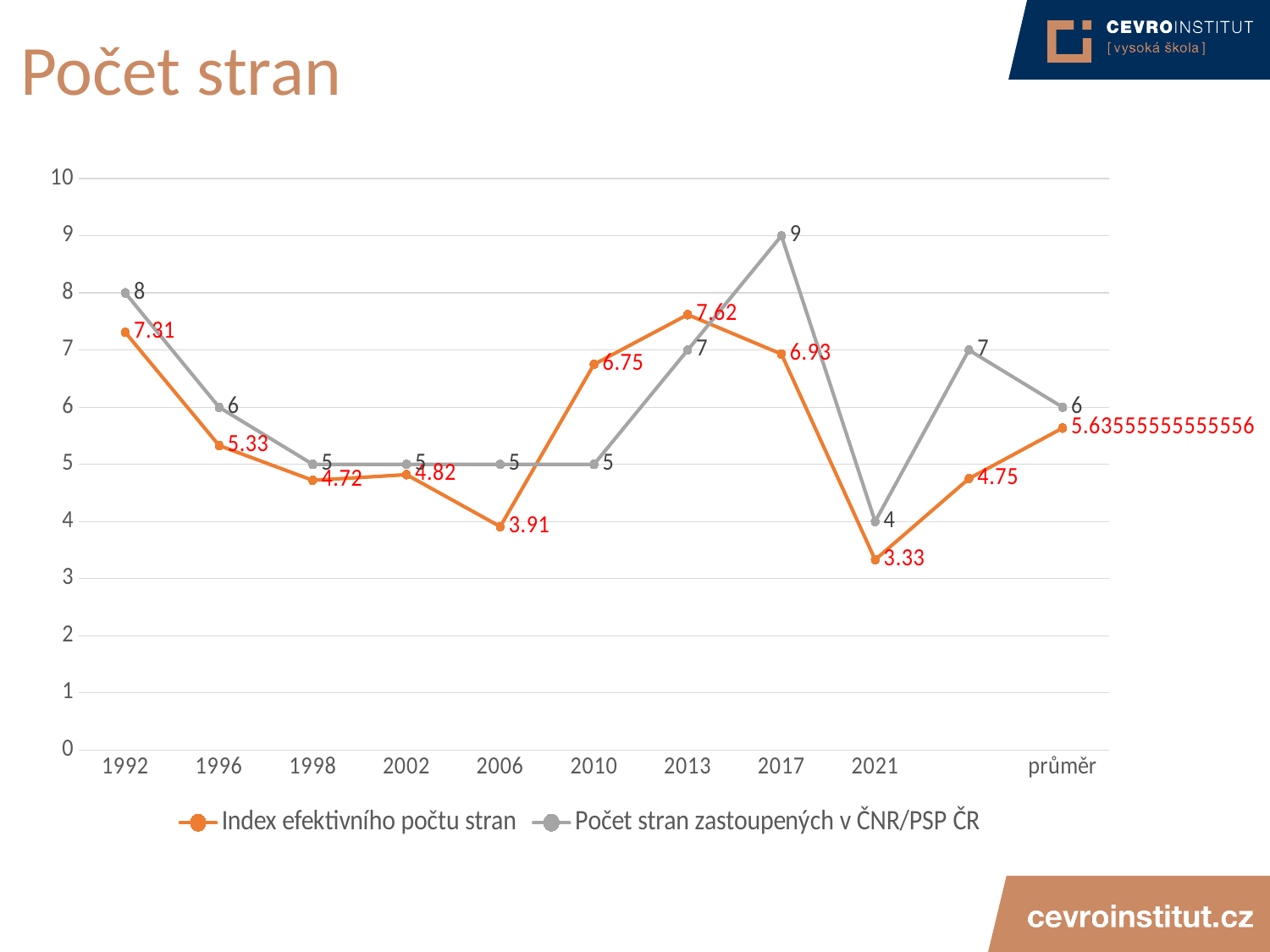
In 2013, which series has the larger value: Index efektivního počtu stran or Počet stran zastoupených v ČNR/PSP ČR? Index efektivního počtu stran What is the value of Počet stran zastoupených v ČNR/PSP ČR in 2017? 9 In which year is Index efektivního počtu stran lowest? 2021 How many series does the legend list? 2 What is the value of Počet stran zastoupených v ČNR/PSP ČR for průměr? 6 What kind of chart is shown on the slide? line chart What is the difference between Počet stran zastoupených v ČNR/PSP ČR and Index efektivního počtu stran in 2017? 2.07 Is the value of Index efektivního počtu stran in 2006 greater or less than 4? less Does Index efektivního počtu stran rise or fall from 1992 to 2006? fall In which year is Index efektivního počtu stran highest? 2013 In which year is Počet stran zastoupených v ČNR/PSP ČR highest? 2017 What is the value of Index efektivního počtu stran in 1992? 7.31